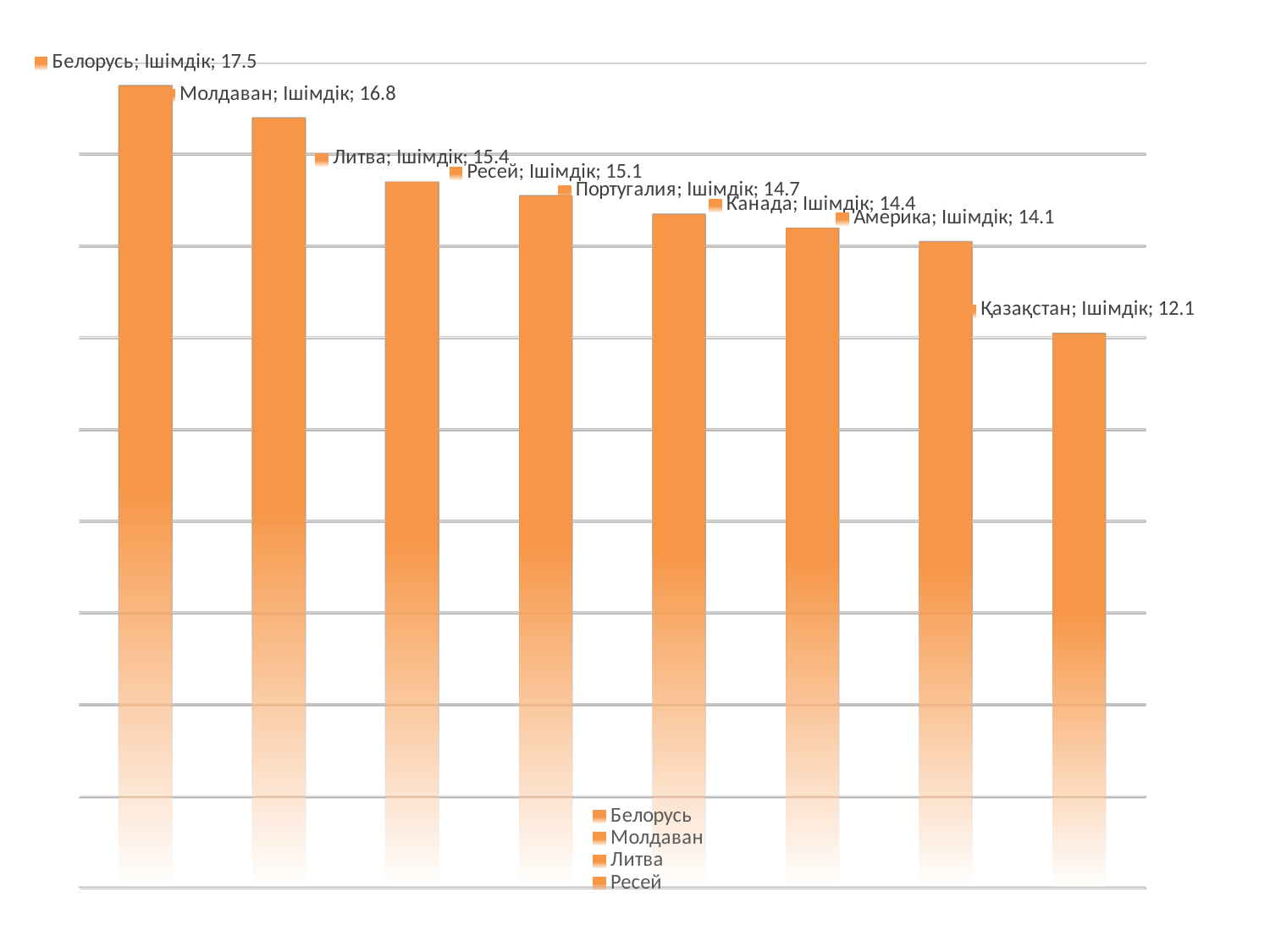
What is the value for Қазақстан? 12.1 Which category has the lowest value? Қазақстан What is the value for Португалия? 14.7 Do the values rise or fall from left to right across the bars? Fall How many bars are shown in the chart? 8 What is the difference between the values for Молдаван and Литва? 1.4 What is the value for Белорусь? 17.5 Which category has the highest value? Белорусь What is the difference between the values for Белорусь and Қазақстан? 5.4 What is the value for Ресей? 15.1 What kind of chart is shown on the slide? Bar chart Which is larger, the value for Канада or the value for Америка? Канада